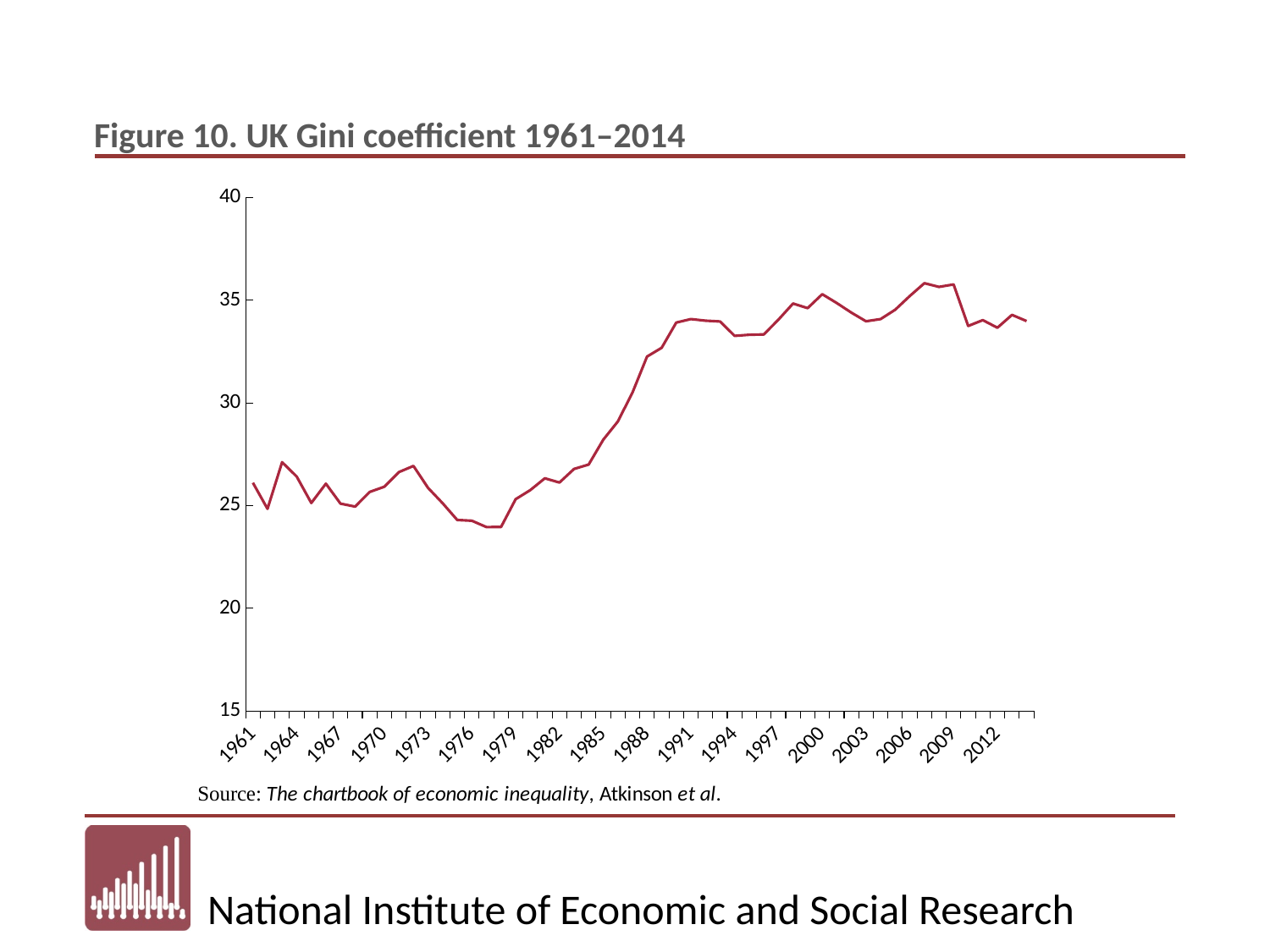
Is the Gini coefficient for 2007 greater or less than 35? greater Is the Gini coefficient for 1985 greater or less than 30? less Does the Gini coefficient rise or fall between 1973 and 1978? fall Does the Gini coefficient rise or fall between 1985 and 1991? rise Which year has the larger Gini coefficient, 1979 or 1991? 1991 What is the title of the chart? Figure 10. UK Gini coefficient 1961–2014 Overall, does the UK Gini coefficient rise or fall between 1961 and 2014? rise Is the Gini coefficient for 1961 greater or less than 25? greater What kind of chart is shown on the slide? line chart Which year has the larger Gini coefficient, 1961 or 2007? 2007